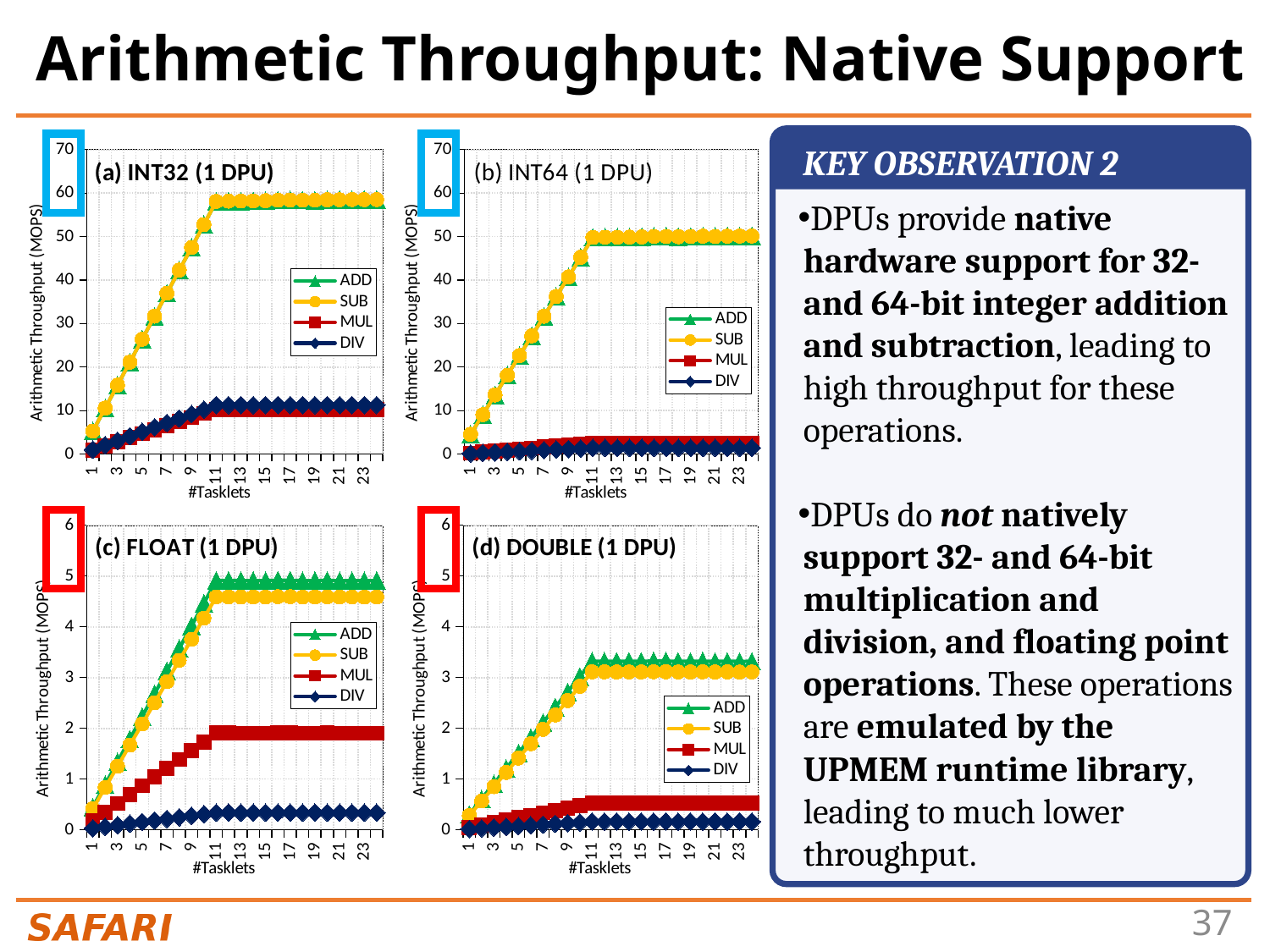
In the '(b) INT64 (1 DPU)' chart, does the ADD throughput rise or fall as the number of tasklets increases from 1 to 11? rise In the '(c) FLOAT (1 DPU)' chart, which series has the lowest throughput at 23 tasklets? DIV What is the label on the x axis of the '(c) FLOAT (1 DPU)' chart? #Tasklets What is the label on the y axis of the '(d) DOUBLE (1 DPU)' chart? Arithmetic Throughput (MOPS) In the '(a) INT32 (1 DPU)' chart, which is larger at 23 tasklets, the ADD throughput or the MUL throughput? ADD In the '(a) INT32 (1 DPU)' chart, is the ADD throughput at 23 tasklets greater or less than 50 MOPS? greater What kind of chart is the '(a) INT32 (1 DPU)' chart? line chart In the '(b) INT64 (1 DPU)' chart, is the SUB throughput at 23 tasklets greater or less than 60 MOPS? less How many series does the legend of the '(b) INT64 (1 DPU)' chart list? 4 In the '(d) DOUBLE (1 DPU)' chart, which is larger at 23 tasklets, the MUL throughput or the DIV throughput? MUL In the '(c) FLOAT (1 DPU)' chart, is the MUL throughput at 23 tasklets greater or less than 1 MOPS? greater